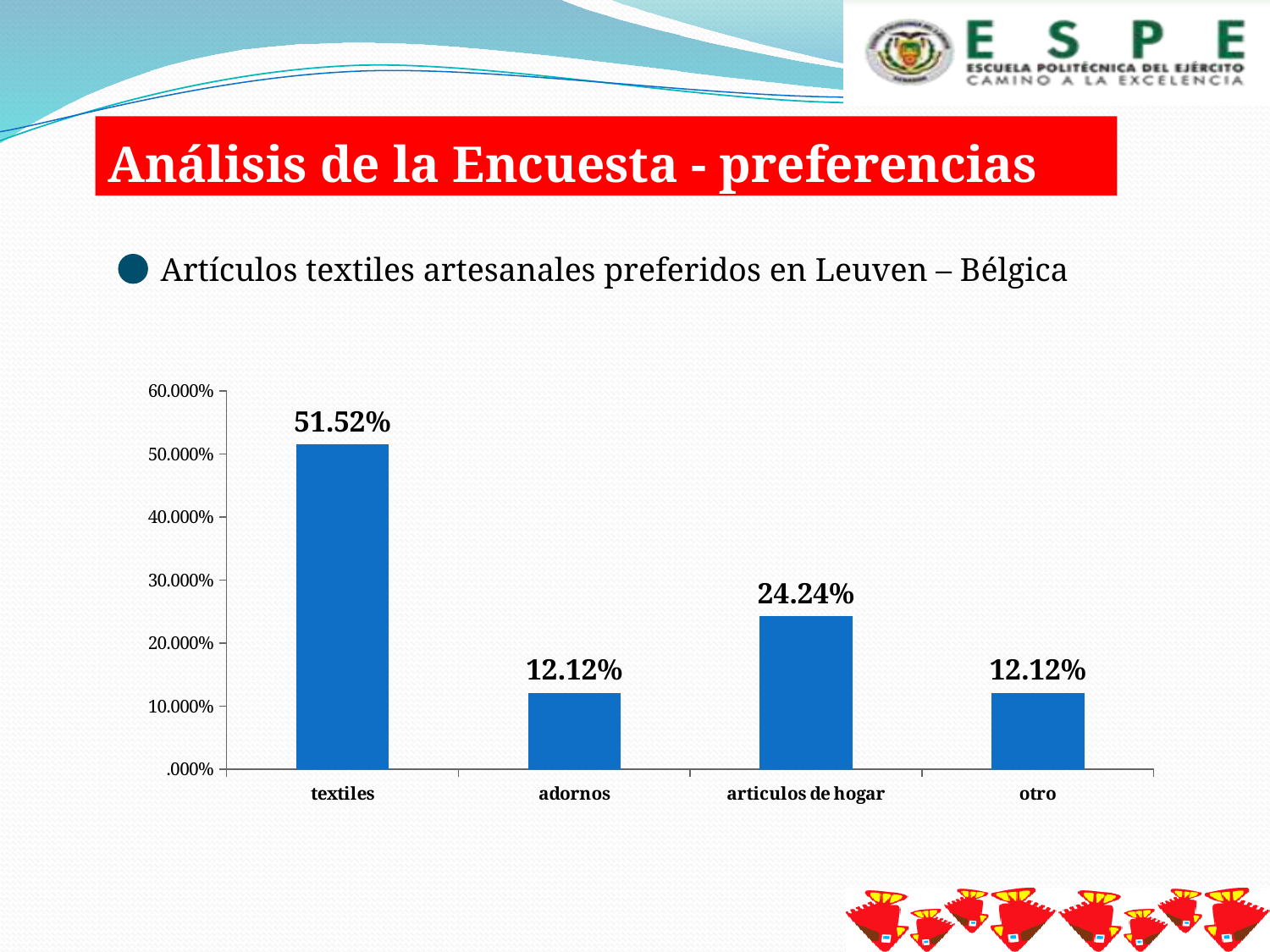
What is the value for textiles? 51.52% What is the difference between the values for textiles and articulos de hogar? 27.28% Is the value for articulos de hogar greater or less than 30.000%? less Which category has the highest value? textiles Is the value for textiles greater or less than 50.000%? greater What is the total of the values for adornos and otro? 24.24% What is the difference between the values for articulos de hogar and otro? 12.12% What is the value for articulos de hogar? 24.24% Which is larger, the value for articulos de hogar or the value for adornos? articulos de hogar What kind of chart is shown on the slide? bar chart How many categories are shown on the x axis? 4 What is the value for adornos? 12.12%